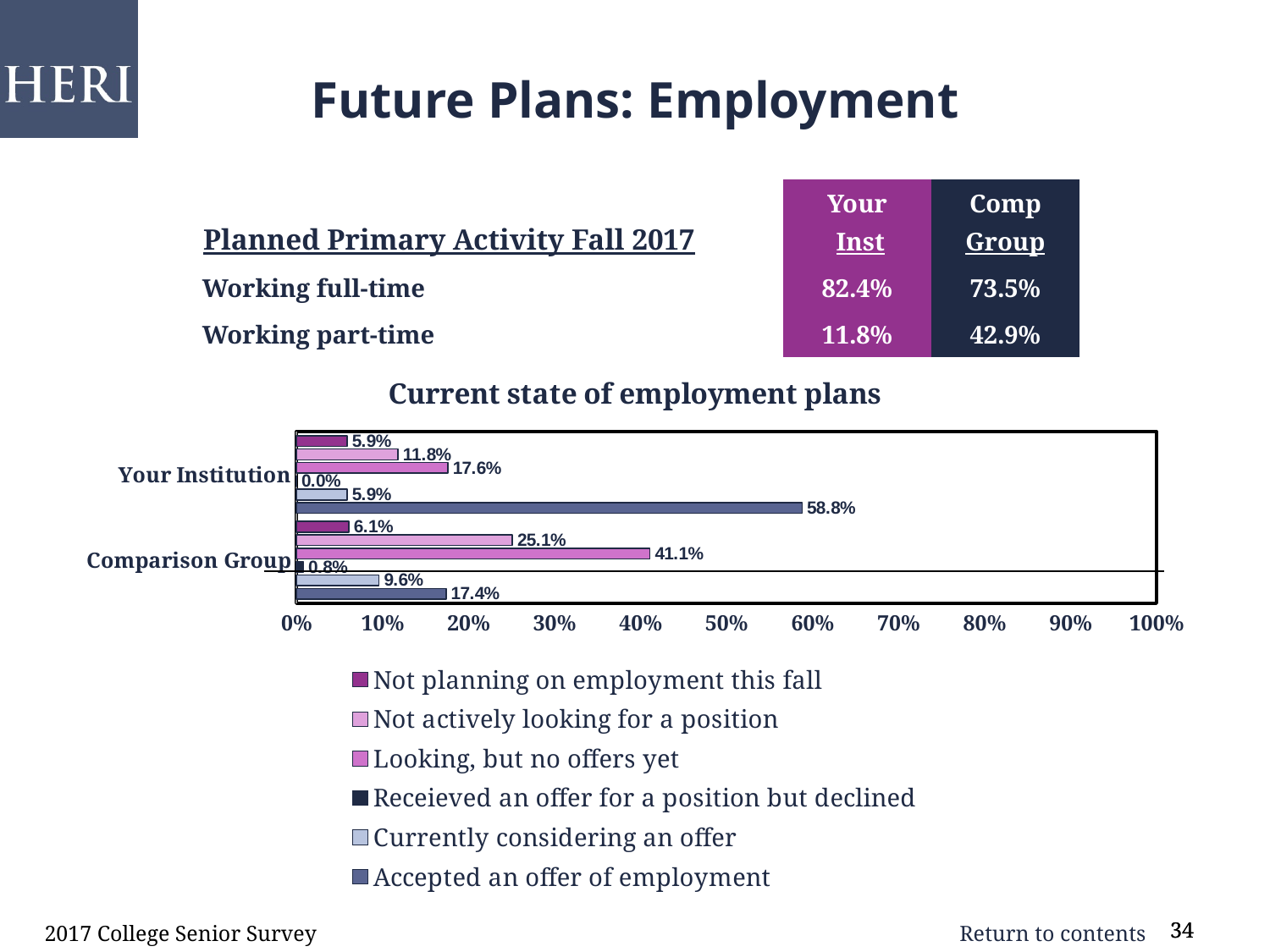
How many categories are shown on the chart? 2 Which series has the highest value for Your Institution? Accepted an offer of employment What is the value for "Not actively looking for a position" for Your Institution? 11.8% What is the value for "Accepted an offer of employment" for Your Institution? 58.8% What kind of chart is shown on the slide? Bar chart What is the value for "Receieved an offer for a position but declined" for the Comparison Group? 0.8% Is the value for "Accepted an offer of employment" for Your Institution greater or less than 50%? greater What is the difference between Your Institution and the Comparison Group for "Accepted an offer of employment"? 41.4% How many series does the legend list? 6 Which is larger for "Looking, but no offers yet": Your Institution or the Comparison Group? Comparison Group What is the value for "Looking, but no offers yet" for the Comparison Group? 41.1% Which series has the lowest value for the Comparison Group? Receieved an offer for a position but declined